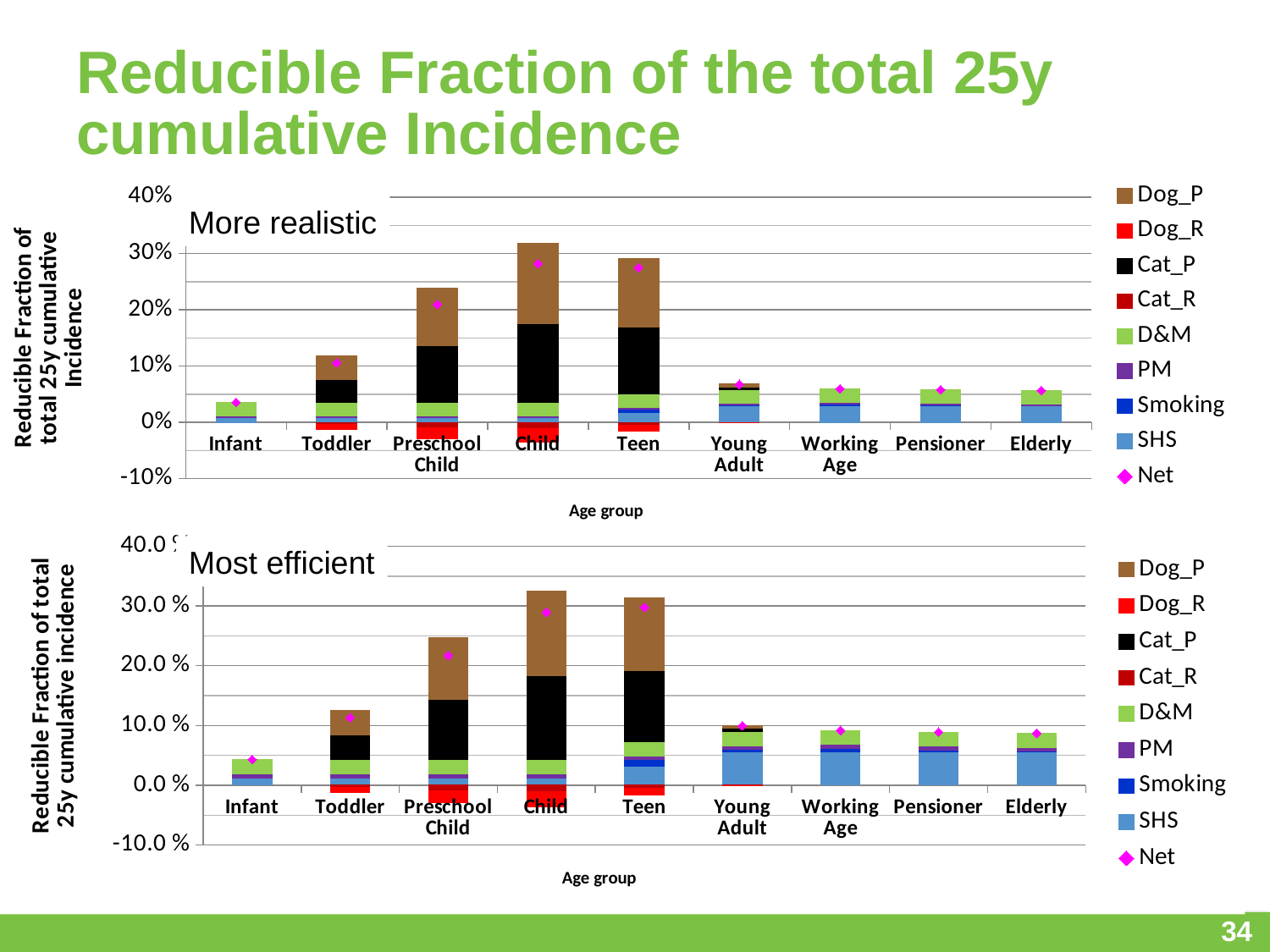
In the top chart ("More realistic"), which age group has the tallest stacked bar? Child In the bottom chart ("Most efficient"), which has the larger Net value, Teen or Young Adult? Teen What is the x-axis title of the bottom chart ("Most efficient")? Age group In the top chart ("More realistic"), which has the larger Net value, Toddler or Preschool Child? Preschool Child How many age groups are shown on the x axis of the top chart ("More realistic")? 9 In the bottom chart ("Most efficient"), which age group has the lowest Net value? Infant In the top chart ("More realistic"), is the Net value for Child greater or less than 20%? greater In the bottom chart ("Most efficient"), is the Net value for Preschool Child greater or less than 10.0 %? greater In the top chart ("More realistic"), which age group has the lowest Net value? Infant In the top chart ("More realistic"), is the Net value for Infant greater or less than 10%? less What kind of chart is the top chart titled "More realistic"? Stacked bar chart How many series does the legend of the bottom chart ("Most efficient") list? 9